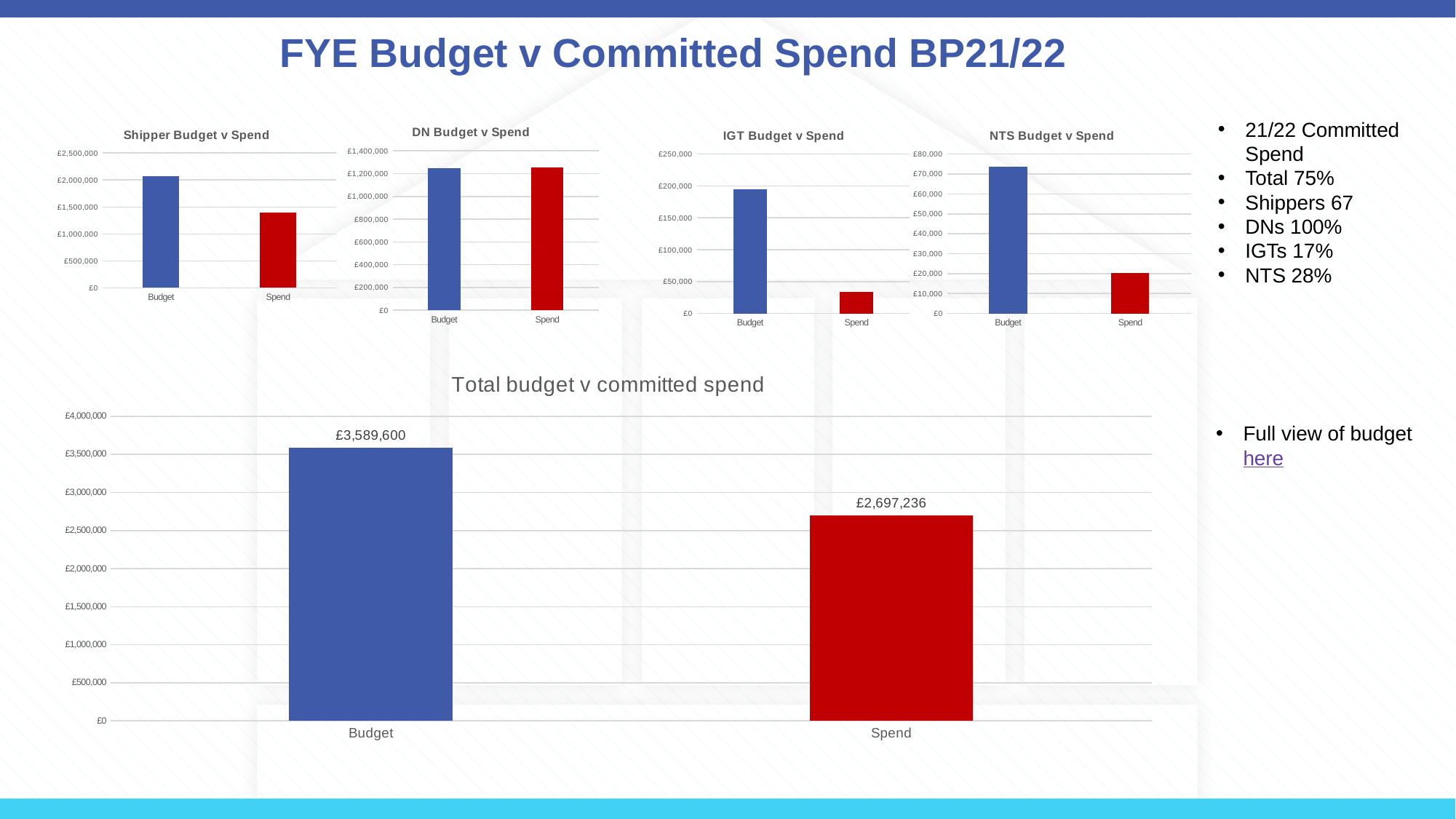
In the Total budget v committed spend chart, which category is higher, Budget or Spend? Budget In the DN Budget v Spend chart, is the value for Budget greater or less than £1,000,000? greater What kind of chart is the Total budget v committed spend chart? Bar chart How many charts are shown on the slide? 5 In the Total budget v committed spend chart, what is the difference between Budget and Spend? £892,364 In the Shipper Budget v Spend chart, is the value for Spend greater or less than £1,500,000? less In the NTS Budget v Spend chart, is the value for Budget greater or less than £60,000? greater In the Shipper Budget v Spend chart, which is larger, Budget or Spend? Budget In the Total budget v committed spend chart, what is the value for Budget? £3,589,600 In the Total budget v committed spend chart, what is the value for Spend? £2,697,236 How many bars are shown in the Total budget v committed spend chart? 2